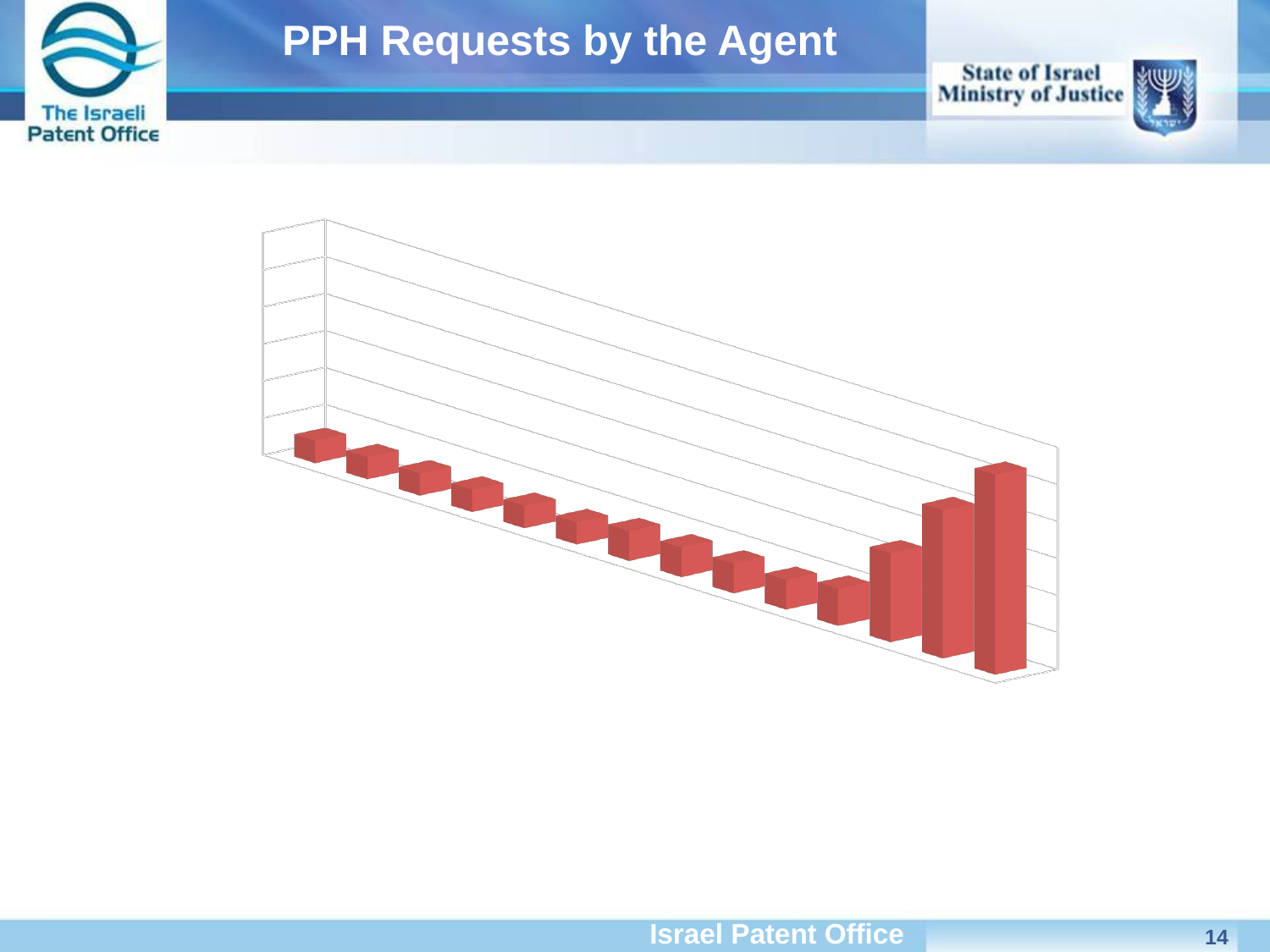
How many bars does the chart contain? 14 Is the rightmost bar larger or smaller than the leftmost bar? larger Is the third bar from the right larger or smaller than the fourth bar from the right? larger Is the second bar from the right larger or smaller than the leftmost bar? larger Which bar has the highest value in the chart? the rightmost (last) bar What colour are the bars in the chart? red Do the values rise sharply at the left end or the right end of the chart? the right end What is the title of the slide containing the chart? PPH Requests by the Agent What kind of chart is shown on the slide? bar chart